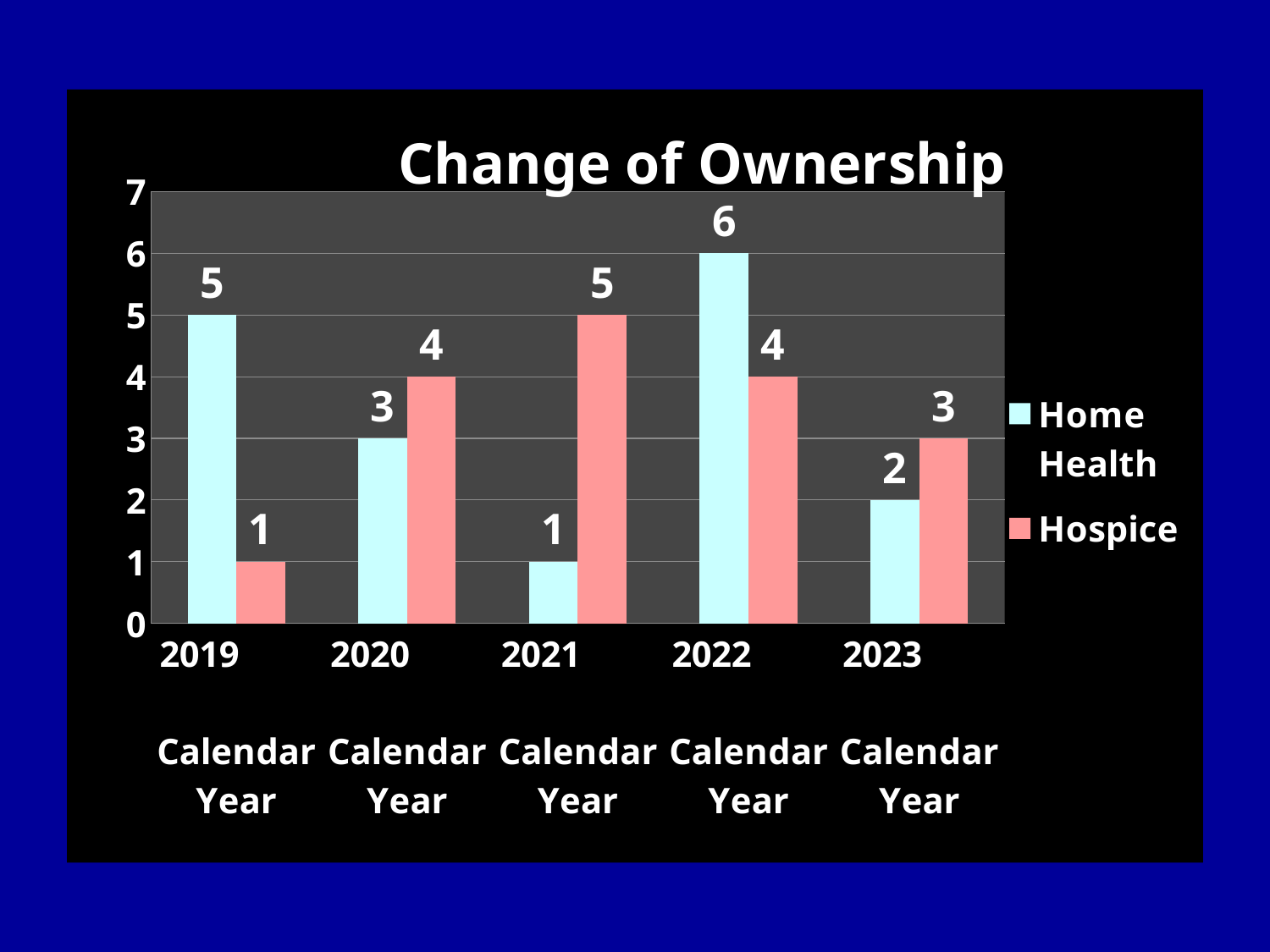
Which series has the larger value in 2020, Home Health or Hospice? Hospice In which year is the Home Health value highest? 2022 What is the Hospice value for 2021? 5 How many years are shown on the x axis? 5 How many series does the legend list? 2 What is the Home Health value for 2023? 2 What is the title of the chart? Change of Ownership What is the difference between the Home Health values for 2019 and 2021? 4 In which year is the Hospice value lowest? 2019 What is the difference between the Home Health and Hospice values in 2022? 2 What kind of chart is shown? Bar chart What is the Home Health value for 2019? 5